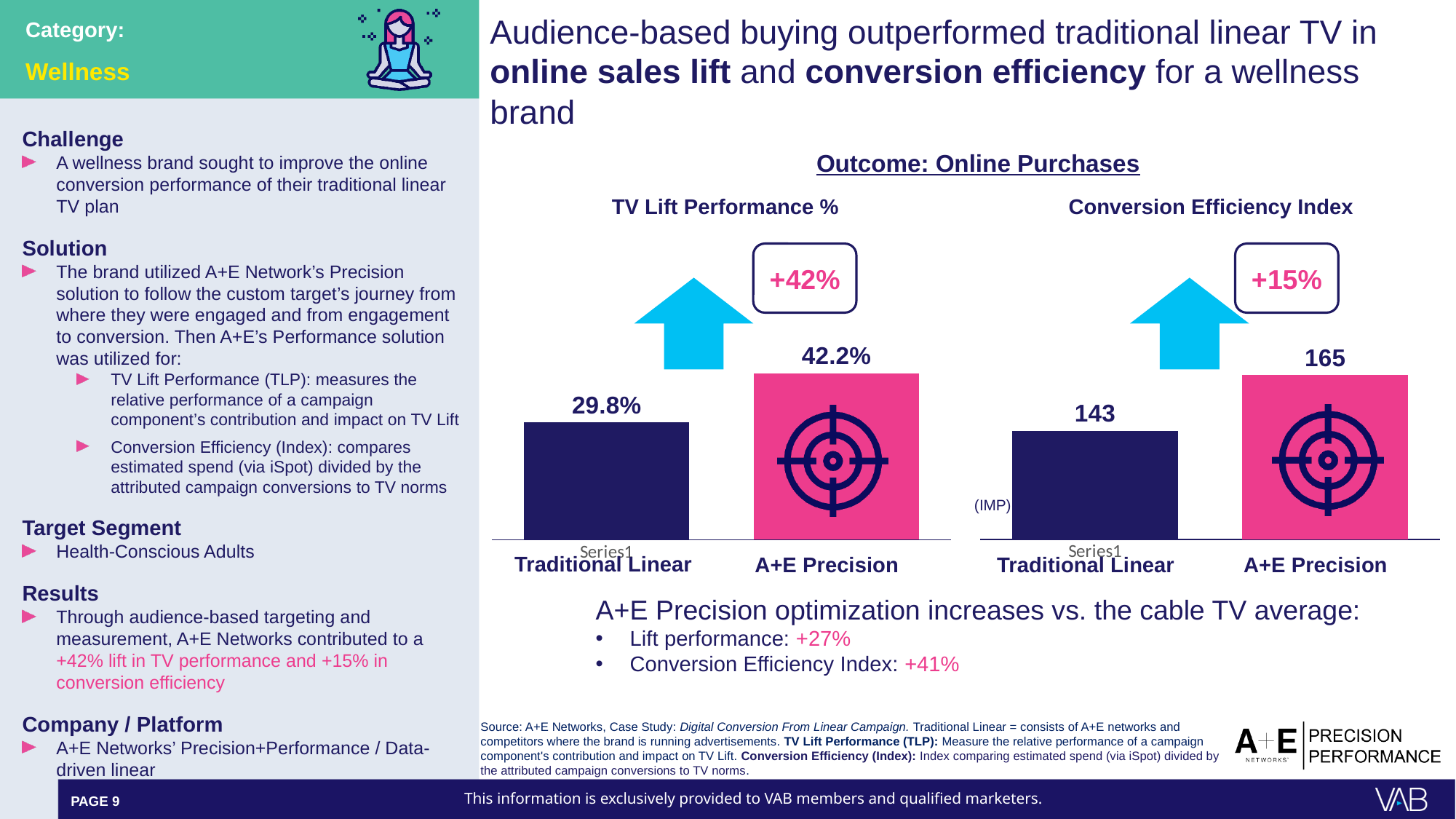
In the Conversion Efficiency Index chart, which category has the lowest value? Traditional Linear In the Conversion Efficiency Index chart, what is the difference between A+E Precision and Traditional Linear? 22 How many categories are shown in the TV Lift Performance % chart? 2 In the TV Lift Performance % chart, which category has the higher value? A+E Precision In the Conversion Efficiency Index chart, what is the value for A+E Precision? 165 What type of chart is the Conversion Efficiency Index chart? bar chart In the TV Lift Performance % chart, what is the difference between A+E Precision and Traditional Linear? 12.4% What percentage increase is shown in the callout box above the TV Lift Performance % chart? +42% In the Conversion Efficiency Index chart, what is the value for Traditional Linear? 143 In the TV Lift Performance % chart, what is the value for Traditional Linear? 29.8% In the Conversion Efficiency Index chart, is the value for A+E Precision larger or smaller than the value for Traditional Linear? larger In the TV Lift Performance % chart, what is the value for A+E Precision? 42.2%